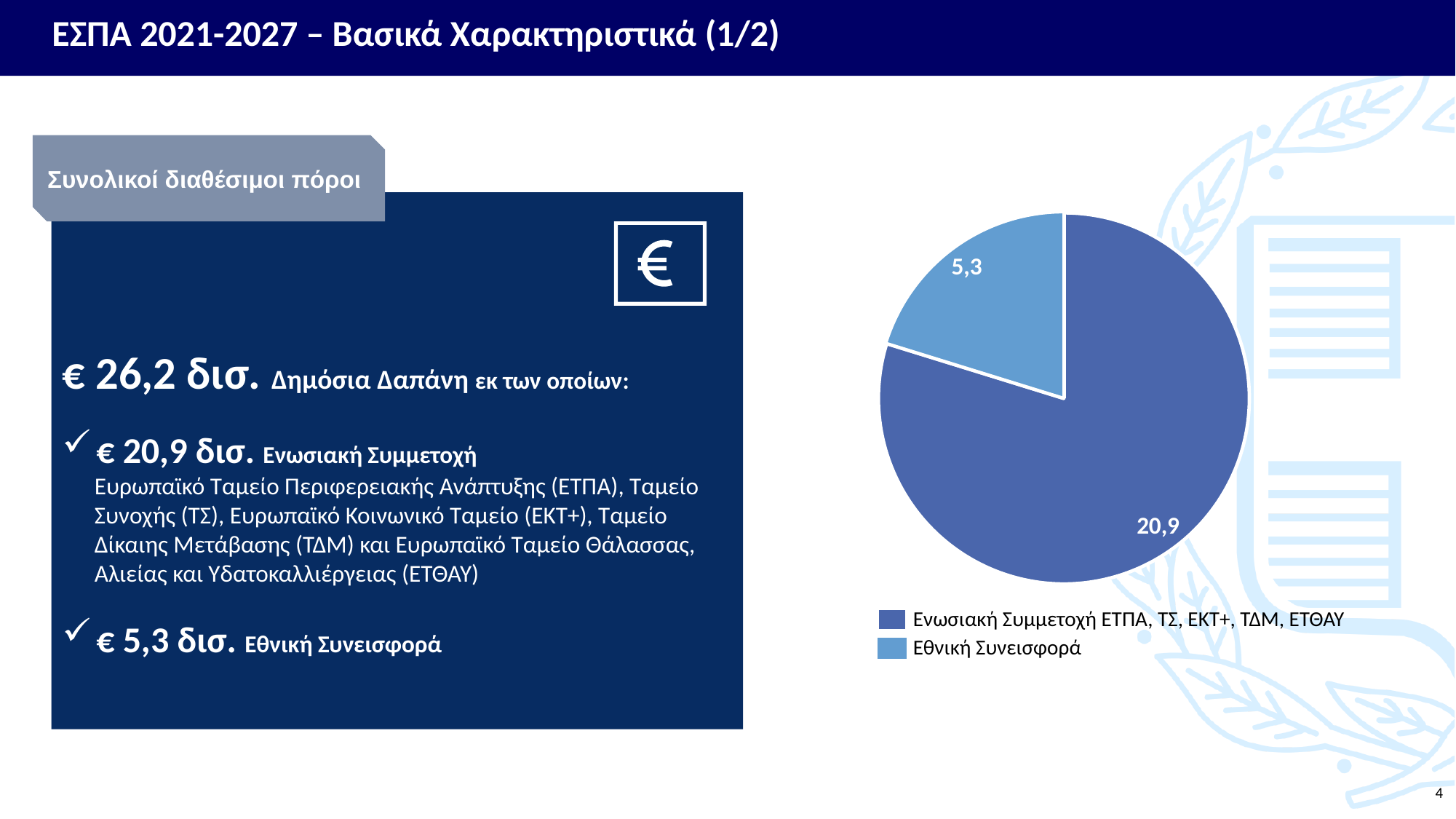
What is the value of the Εθνική Συνεισφορά slice in the pie chart? 5,3 How many entries does the legend of the pie chart list? 2 What is the value of the Ενωσιακή Συμμετοχή ΕΤΠΑ, ΤΣ, ΕΚΤ+, ΤΔΜ, ΕΤΘΑΥ slice in the pie chart? 20,9 Which legend entry is shown in dark blue in the pie chart? Ενωσιακή Συμμετοχή ΕΤΠΑ, ΤΣ, ΕΚΤ+, ΤΔΜ, ΕΤΘΑΥ How many slices does the pie chart have? 2 Which is larger in the pie chart: Εθνική Συνεισφορά or Ενωσιακή Συμμετοχή? Ενωσιακή Συμμετοχή Which slice of the pie chart is the smallest? Εθνική Συνεισφορά Which slice of the pie chart is the largest? Ενωσιακή Συμμετοχή ΕΤΠΑ, ΤΣ, ΕΚΤ+, ΤΔΜ, ΕΤΘΑΥ What kind of chart is shown on the slide? pie chart What is the difference between the Ενωσιακή Συμμετοχή slice and the Εθνική Συνεισφορά slice in the pie chart? 15,6 What is the total of the two slices in the pie chart? 26,2 Which colour represents Εθνική Συνεισφορά in the pie chart? light blue